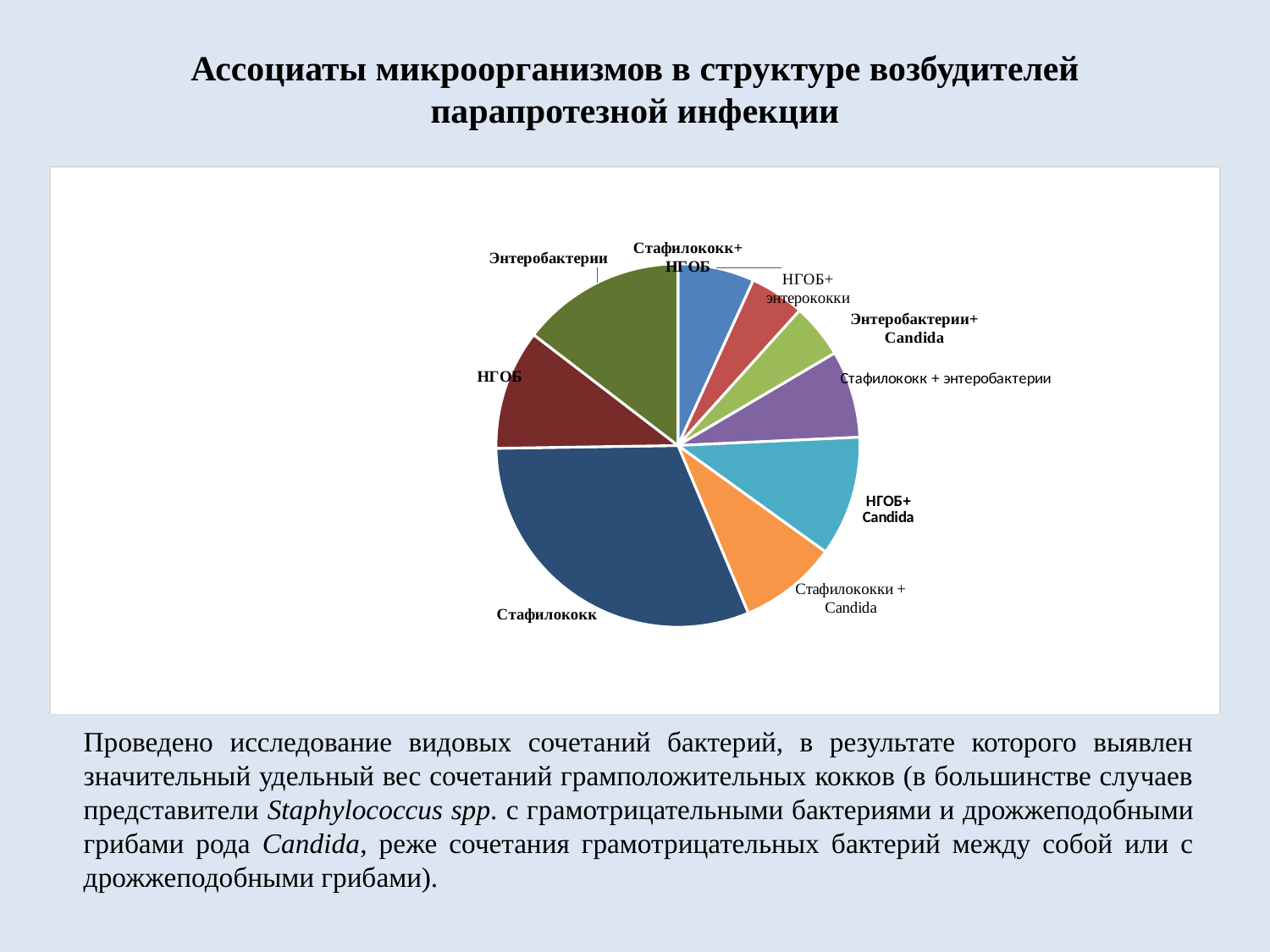
Which slice is larger: Стафилококк or Энтеробактерии? Стафилококк What is the title of the slide containing the pie chart? Ассоциаты микроорганизмов в структуре возбудителей парапротезной инфекции Which slice is larger: Энтеробактерии or НГОБ+Candida? Энтеробактерии How many slices (categories) does the pie chart have? 9 Which category has the largest slice in the pie chart? Стафилококк What colour is the Стафилококк slice in the pie chart? Dark blue What kind of chart is shown on the slide? Pie chart Which slice is larger: НГОБ or Стафилококки + Candida? НГОБ